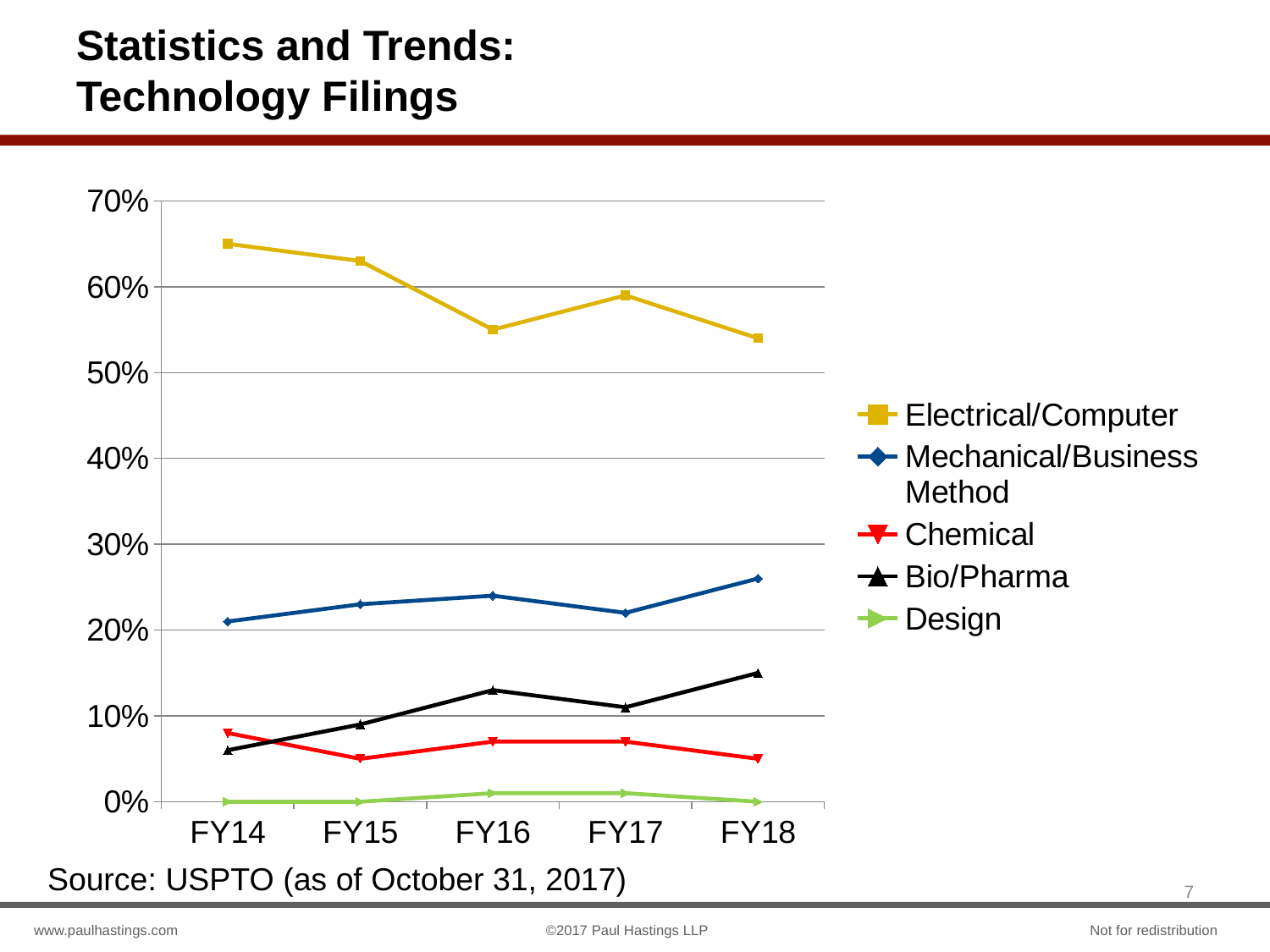
How many fiscal years are shown on the x axis? 5 Does the Electrical/Computer series rise or fall overall from FY14 to FY18? fall Is the value for Mechanical/Business Method in FY18 greater or less than 20%? greater Which series has the highest value in FY14? Electrical/Computer What colour is the Chemical line? red Is the value for Electrical/Computer in FY14 greater or less than 60%? greater Which is larger in FY18, Mechanical/Business Method or Bio/Pharma? Mechanical/Business Method What kind of chart is shown on the slide? line chart Is the value for Electrical/Computer in FY16 greater or less than 60%? less Which series has the lowest value in FY18? Design How many series does the legend list? 5